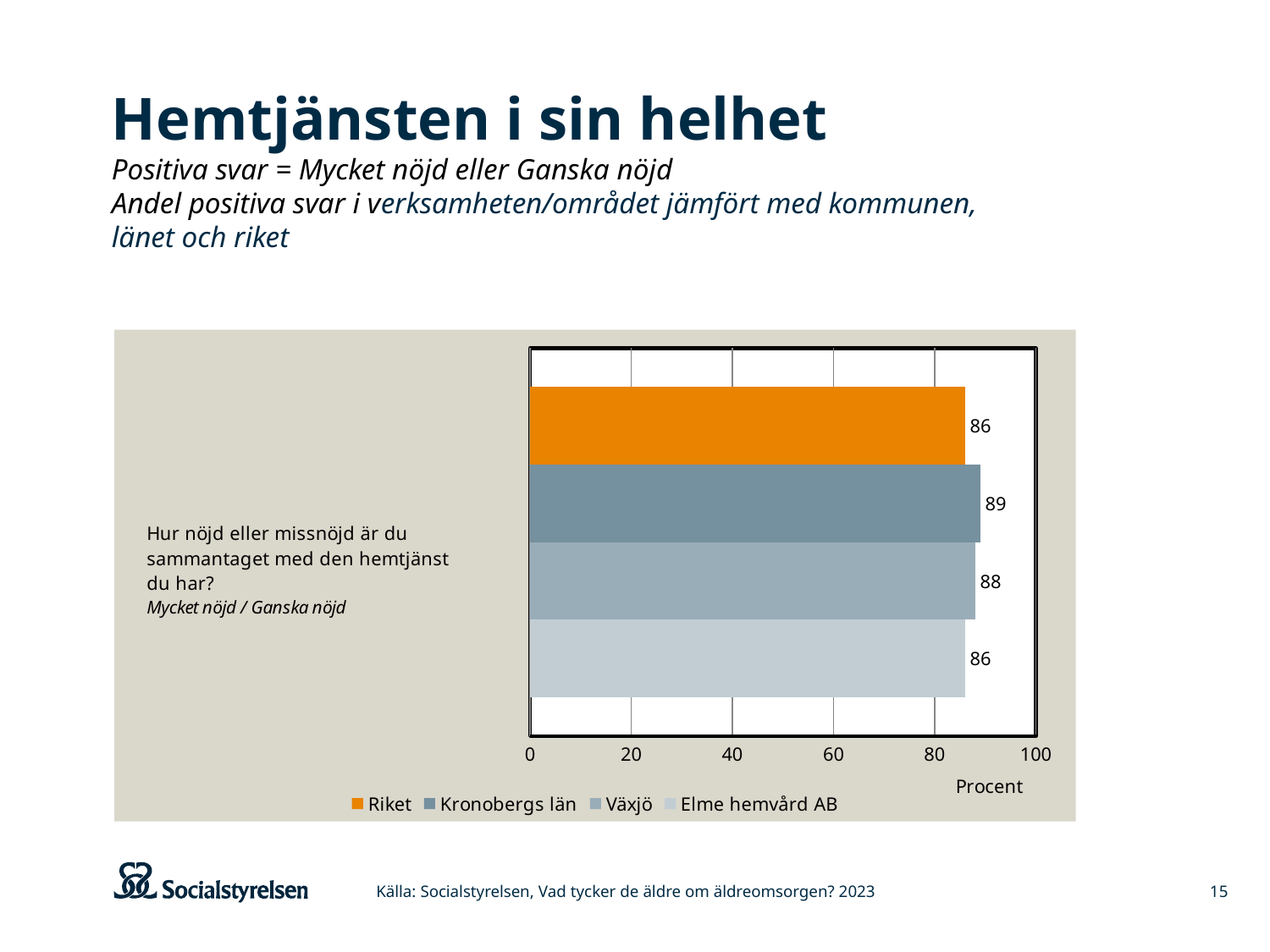
What is the difference between the values for Växjö and Elme hemvård AB? 2 Which is larger, the value for Kronobergs län or the value for Växjö? Kronobergs län What kind of chart is shown on the slide? Bar chart Is the value for Riket greater or less than 80? greater What is the value for Riket? 86 How many bars are plotted in the chart? 4 How many series does the legend list? 4 What is the value for Elme hemvård AB? 86 Which series has the highest value? Kronobergs län What is the difference between the values for Kronobergs län and Riket? 3 What is the value for Växjö? 88 What is the value for Kronobergs län? 89